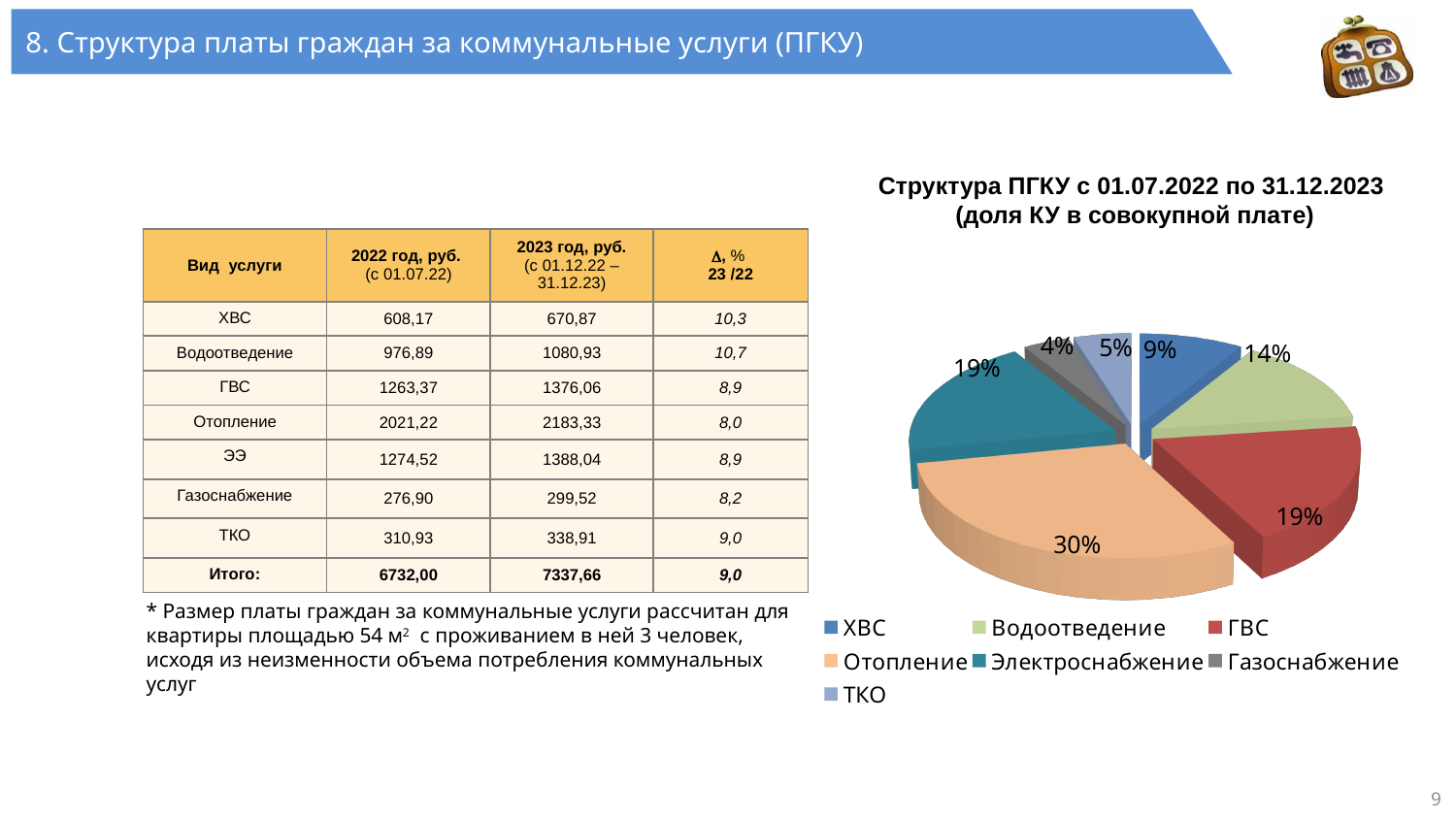
Which slice is larger, Водоотведение or ХВС? Водоотведение What is the difference in percentage points between the Отопление slice and the ГВС slice? 11 What share of the pie does Газоснабжение have? 4% Which category has the smallest slice of the pie? Газоснабжение Which category has the largest slice of the pie? Отопление What share of the pie does ТКО have? 5% What share of the pie does Водоотведение have? 14% How many categories does the legend of the pie chart list? 7 What is the title of the pie chart? Структура ПГКУ с 01.07.2022 по 31.12.2023 (доля КУ в совокупной плате) What kind of chart is shown on the slide? pie chart